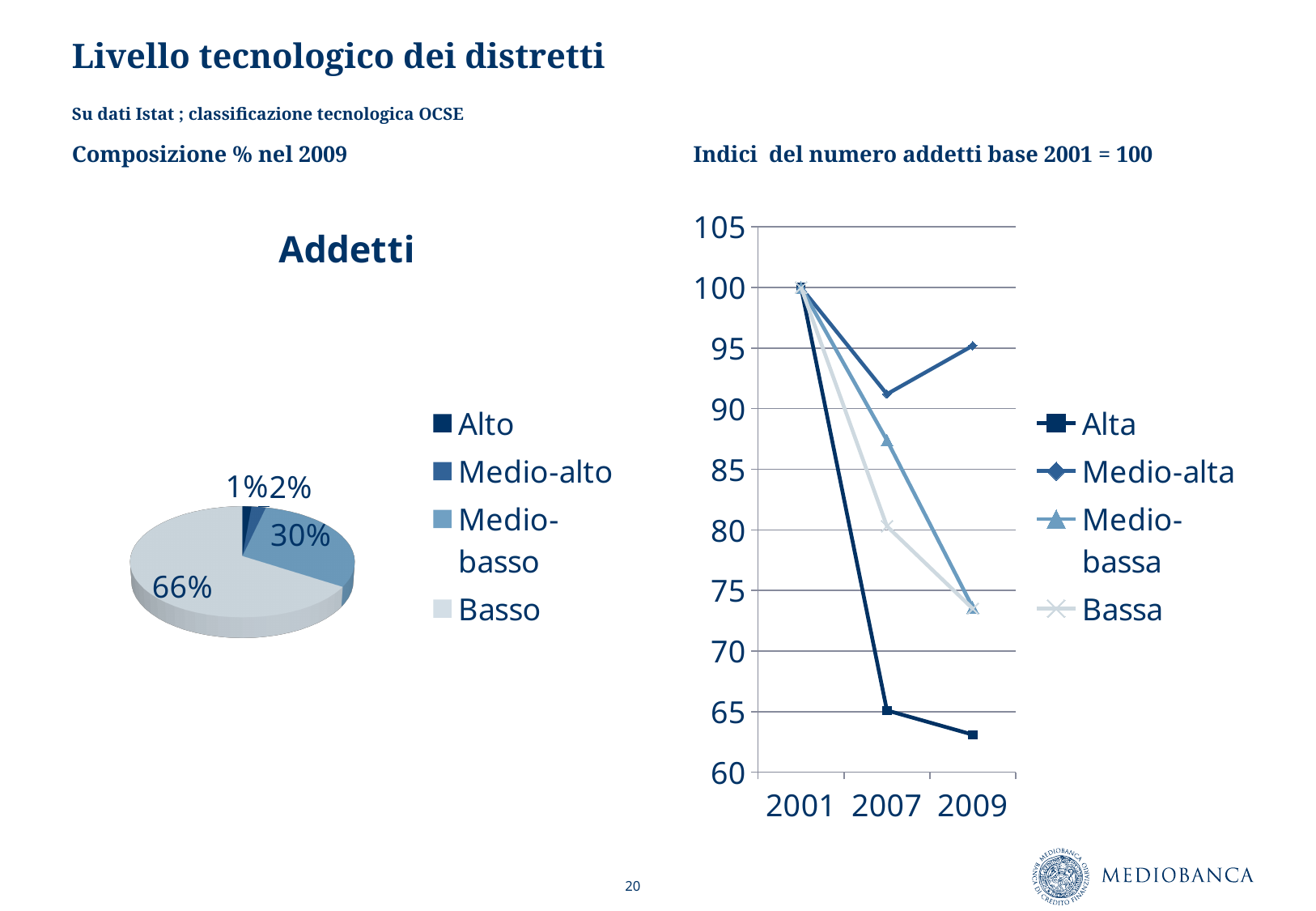
In the line chart on the right, which series has the lowest value in 2009? Alta In the line chart on the right, which series has the highest value in 2009? Medio-alta In the line chart on the right, how many series does the legend list? 4 In the pie chart titled Addetti, how many categories does the legend list? 4 In the pie chart titled Addetti, what is the difference in percentage points between Basso and Medio-basso? 36 In the pie chart titled Addetti, which category has the largest share? Basso In the pie chart titled Addetti, what share does Medio-basso have? 30% In the line chart on the right, is the value for Alta in 2009 greater or less than 65? less In the pie chart titled Addetti, which category has the smallest share? Alto What kind of chart is the chart on the left of the slide? pie chart In the pie chart titled Addetti, what share does Basso have? 66% What kind of chart is the chart on the right of the slide? line chart